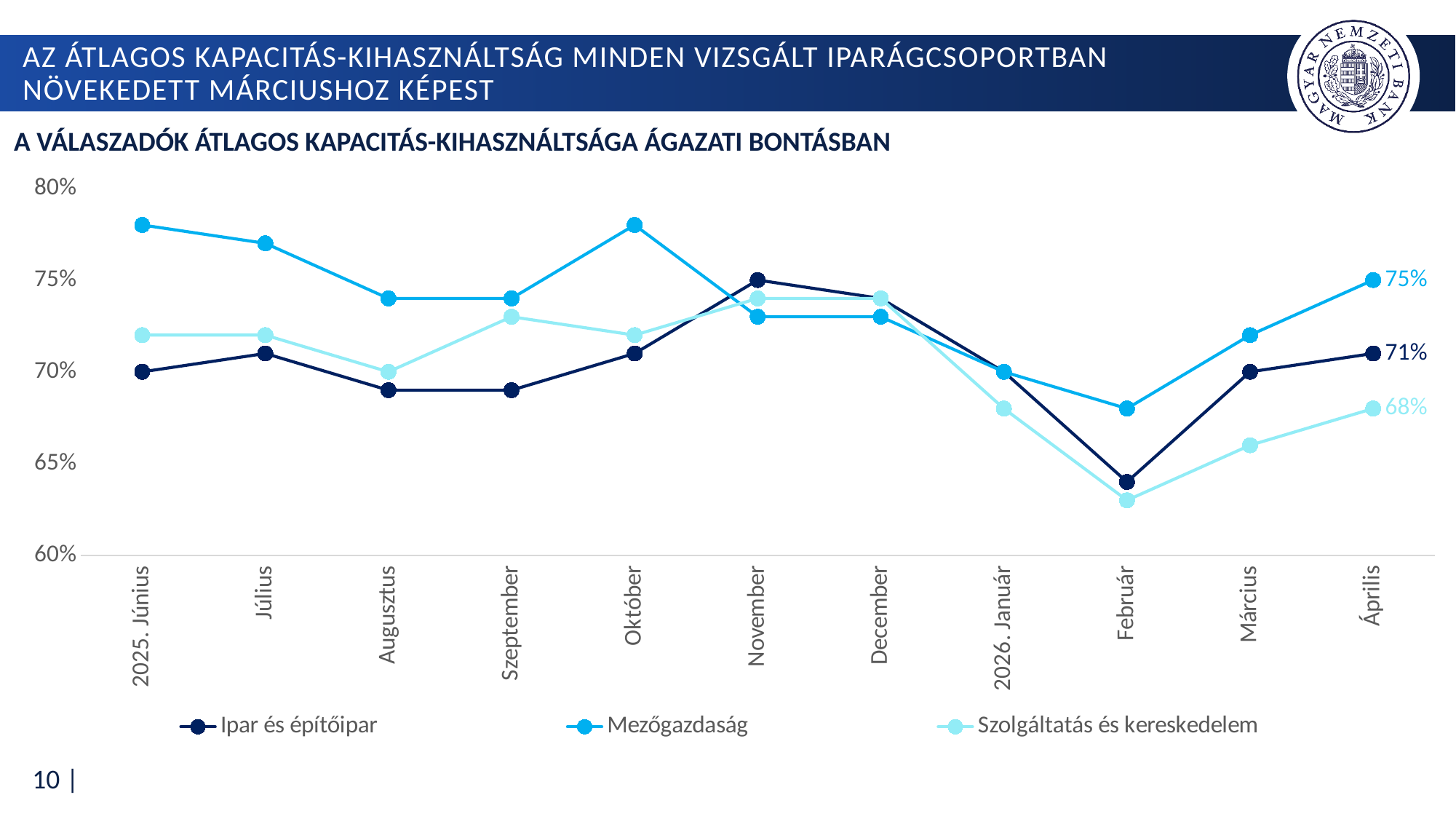
What is the value for Szolgáltatás és kereskedelem in Április? 68% How many months are shown on the x axis? 11 Which series has the highest value in Április? Mezőgazdaság Is the value for Szolgáltatás és kereskedelem in Február greater or less than 65%? less What is the value for Ipar és építőipar in Április? 71% In Április, how many percentage points higher is Mezőgazdaság than Szolgáltatás és kereskedelem? 7 percentage points What is the value for Mezőgazdaság in Április? 75% Is the value for Mezőgazdaság in 2025. Június greater or less than 75%? greater How many series does the legend list? 3 In which month is Ipar és építőipar at its lowest? Február In Április, which is larger: Ipar és építőipar or Szolgáltatás és kereskedelem? Ipar és építőipar What kind of chart is shown on the slide? Line chart